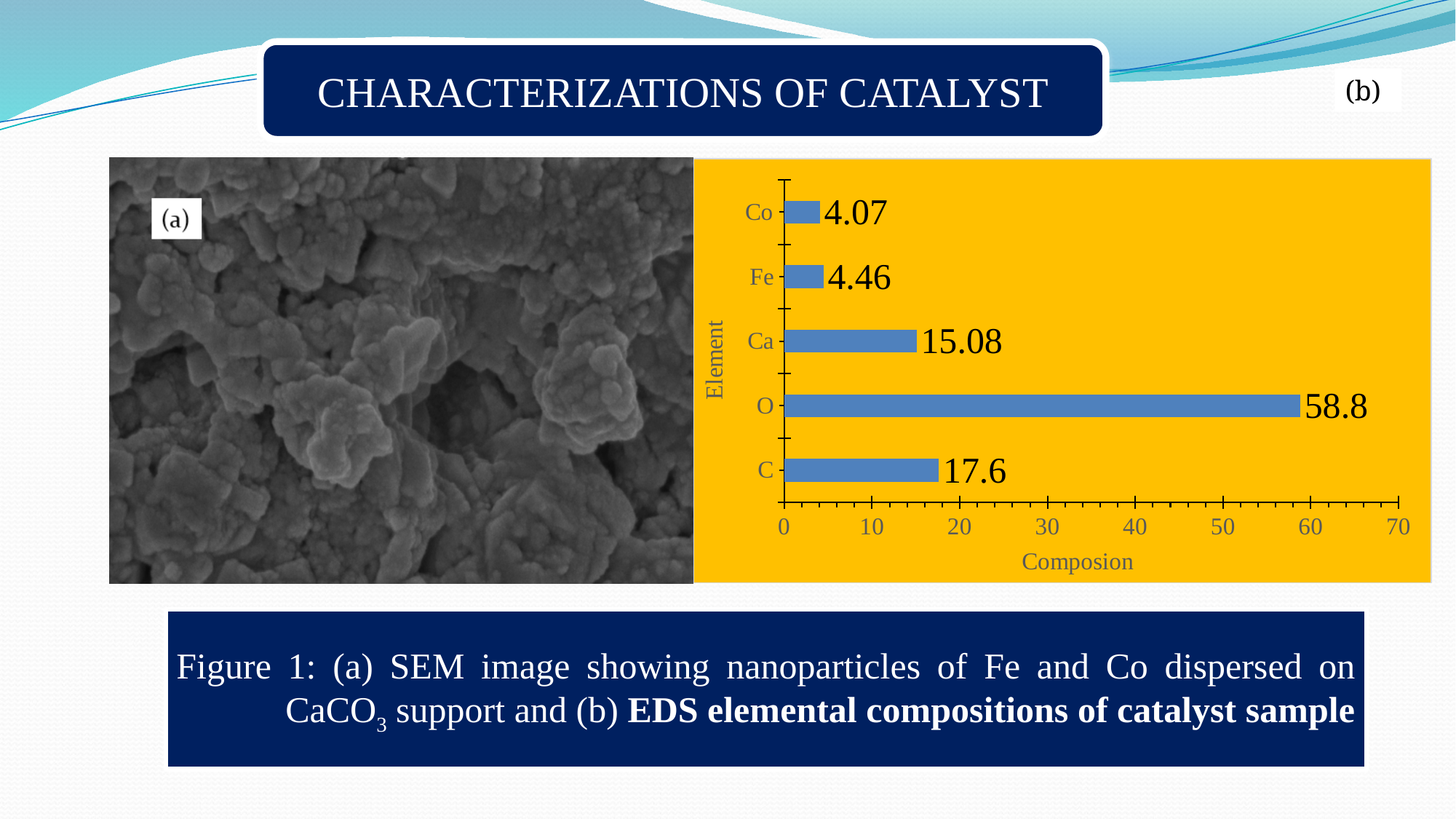
What kind of chart is shown on the slide? Bar chart Which element has the lowest composition value? Co What is the difference between the composition values for O and C? 41.2 What is the composition value for Co? 4.07 What is the difference between the composition values for Fe and Co? 0.39 What is the composition value for O? 58.8 What is the composition value for Ca? 15.08 Which element has the highest composition value? O Which has a larger composition value, C or Ca? C What is the composition value for Fe? 4.46 What is the label of the horizontal axis of the chart? Composion How many elements are shown in the chart? 5